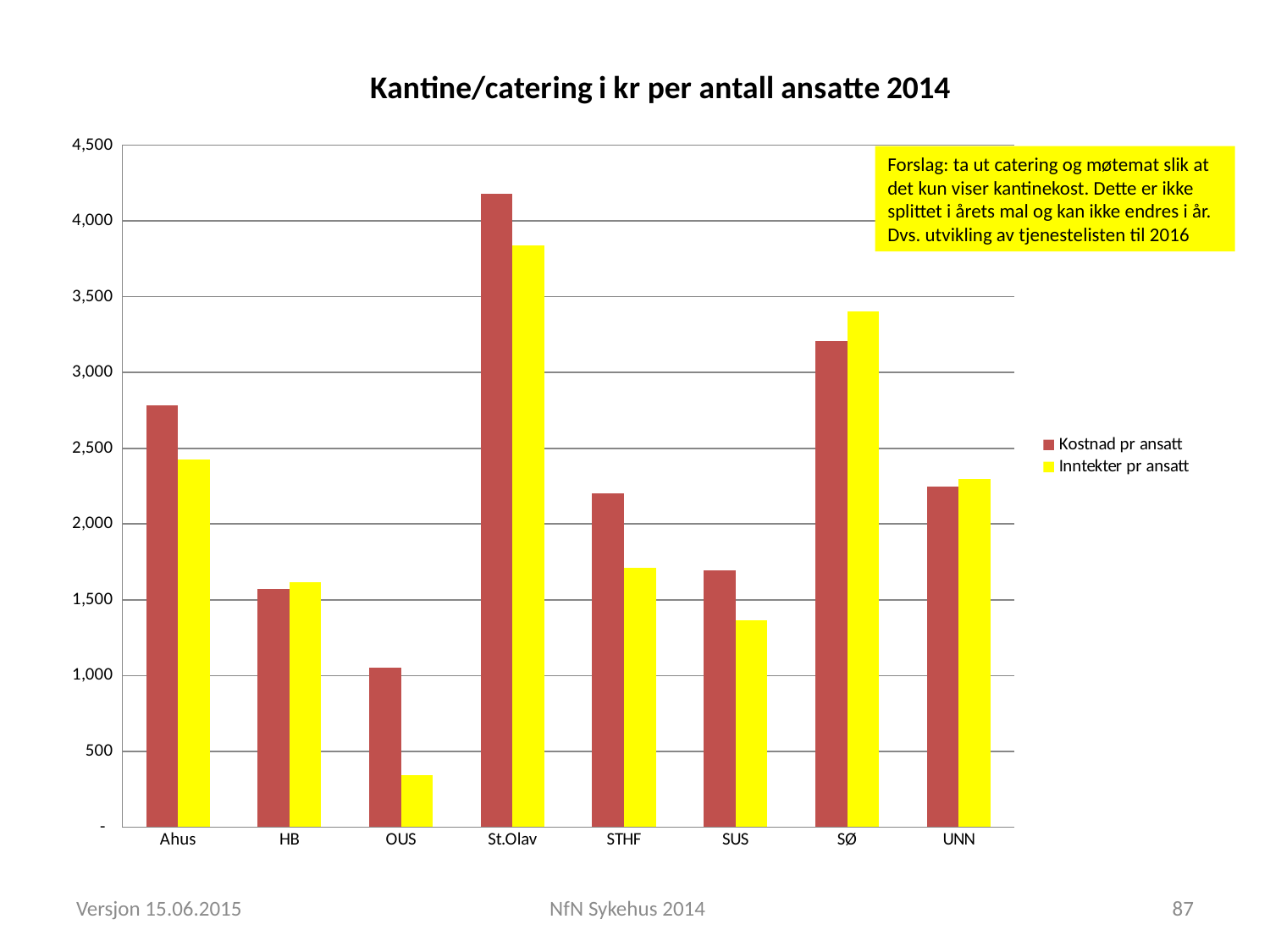
For Ahus, which is larger: Kostnad pr ansatt or Inntekter pr ansatt? Kostnad pr ansatt What is the title of the chart? Kantine/catering i kr per antall ansatte 2014 Which hospital has the highest Kostnad pr ansatt? St.Olav For SØ, which is larger: Kostnad pr ansatt or Inntekter pr ansatt? Inntekter pr ansatt What type of chart is shown on the slide? Bar chart Is the Kostnad pr ansatt for St.Olav greater or less than 4,000? greater How many hospitals (categories) are shown on the x axis? 8 Which hospital has the lowest Inntekter pr ansatt? OUS Is the Inntekter pr ansatt for OUS greater or less than 500? less Which hospital has the lowest Kostnad pr ansatt? OUS Is the Inntekter pr ansatt for SØ greater or less than 3,000? greater How many series does the legend list? 2